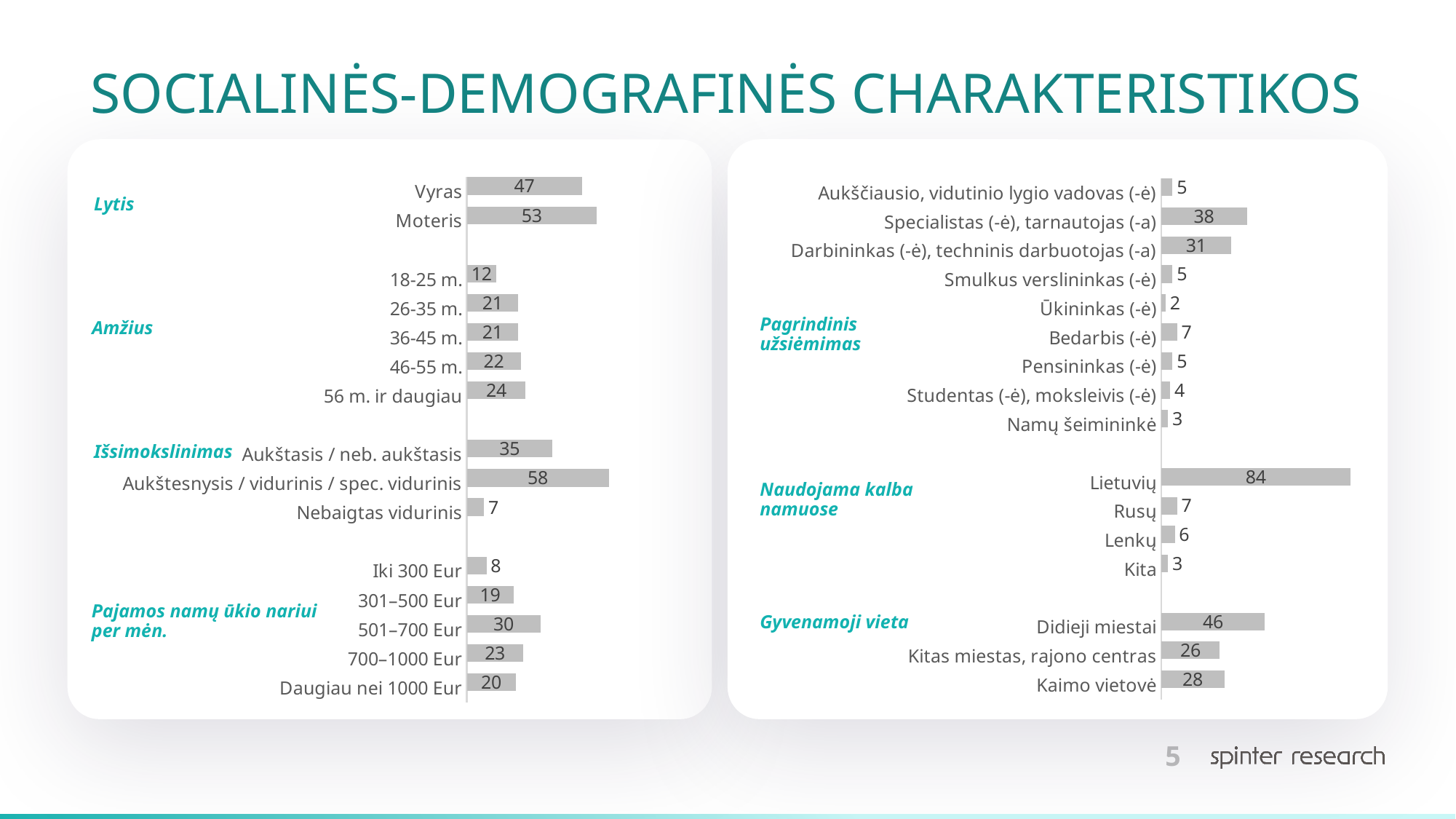
In the left chart, what is the difference between the values for Moteris and Vyras? 6 In the right chart, which is larger: the value for Didieji miestai or the value for Kitas miestas, rajono centras? Didieji miestai In the right chart, what is the difference between the values for Lietuvių and Rusų? 77 What kind of chart is the left chart? Bar chart In the left chart, which is larger: the value for 501–700 Eur or the value for 700–1000 Eur? 501–700 Eur In the left chart, what is the value for Moteris? 53 How many bars are plotted in the right chart? 16 In the left chart, which category has the highest value? Aukštesnysis / vidurinis / spec. vidurinis In the right chart, what is the value for Kaimo vietovė? 28 In the right chart, which category has the lowest value? Ūkininkas (-ė) In the right chart, what is the value for Specialistas (-ė), tarnautojas (-a)? 38 In the left chart, what is the value for 56 m. ir daugiau? 24